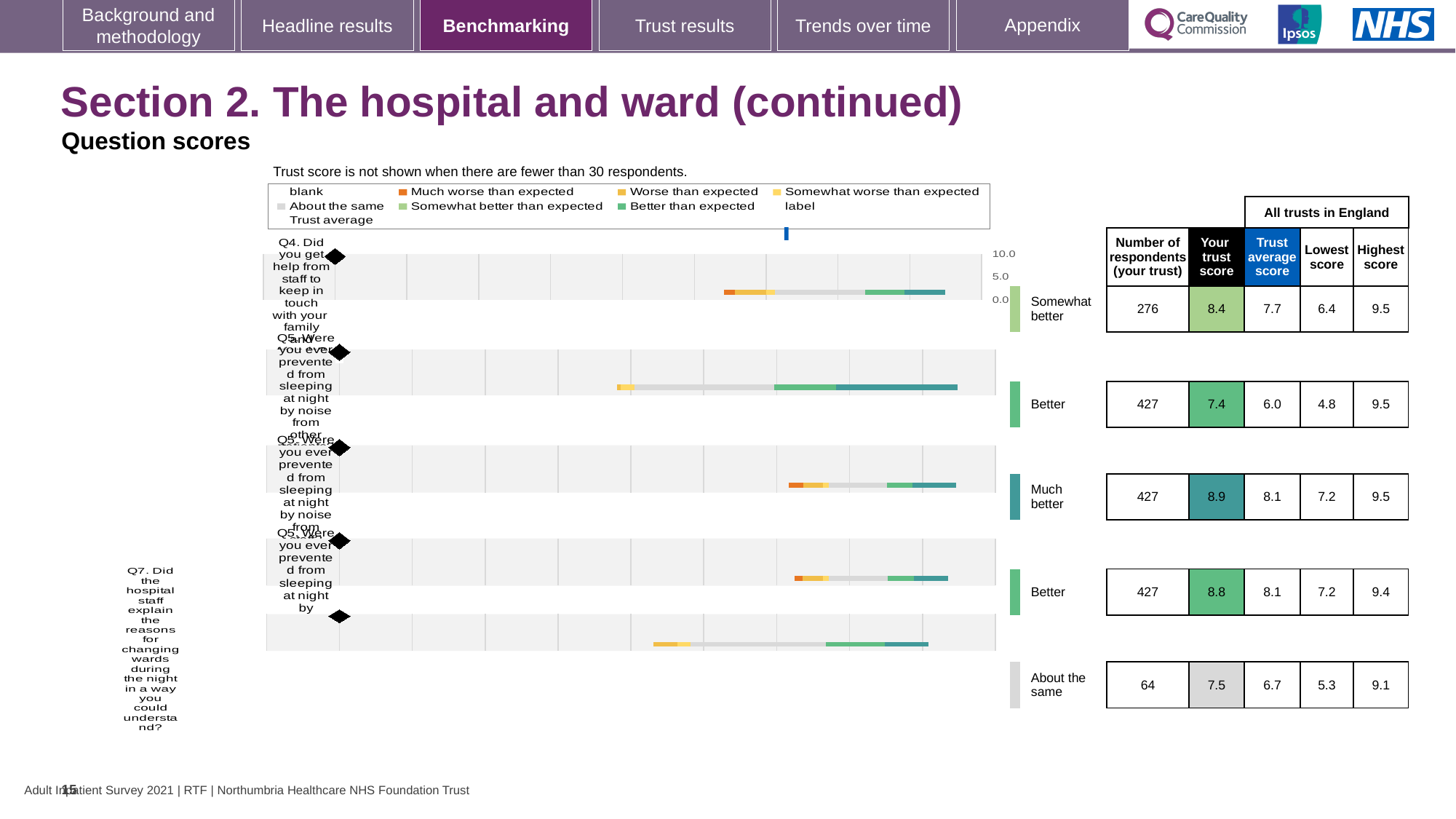
In the table beside the chart, how many respondents are listed for the row labelled 'About the same'? 64 Which row in the table beside the chart has the highest 'Your trust score'? Much better Which legend entry is shown in orange? Much worse than expected In the table beside the chart, what is the 'Your trust score' for the row labelled 'Much better'? 8.9 For the row labelled 'About the same', which is larger: 'Your trust score' or 'Trust average score'? Your trust score In the table beside the chart, what is the 'Highest score' for the row labelled 'Somewhat better'? 9.5 Which row in the table beside the chart has the lowest number of respondents? About the same In the table beside the chart, what is the 'Trust average score' for the row labelled 'Much better'? 8.1 For the row labelled 'Much better', what is the difference between 'Your trust score' and 'Trust average score'? 0.8 What is the maximum value shown on the chart's score axis? 10.0 What kind of chart is shown on the slide? bar chart How many horizontal bars are plotted in the chart? 5